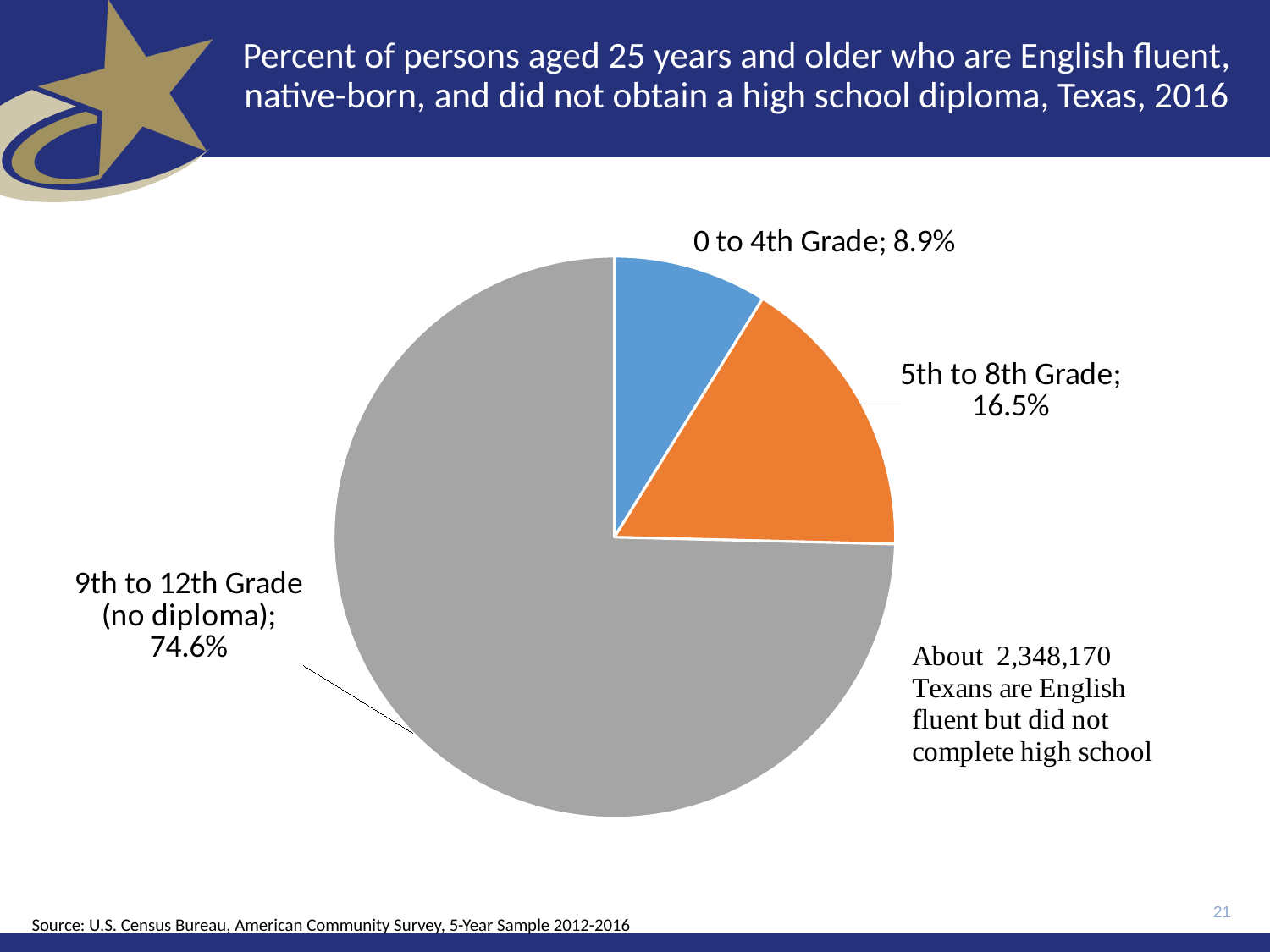
What is the difference in percentage points between the 5th to 8th Grade slice and the 0 to 4th Grade slice? 7.6 What percentage is shown for the 9th to 12th Grade (no diploma) slice? 74.6% According to the text on the slide, about how many Texans are English fluent but did not complete high school? 2,348,170 Which category has the largest share of the pie? 9th to 12th Grade (no diploma) Which category has the smallest share of the pie? 0 to 4th Grade What colour is the 5th to 8th Grade slice? orange What share of the pie does the 9th to 12th Grade (no diploma) slice represent? 74.6% Which is larger, the 5th to 8th Grade slice or the 0 to 4th Grade slice? 5th to 8th Grade What percentage is shown for the 5th to 8th Grade slice? 16.5% What type of chart is shown on the slide? pie chart How many slices does the pie chart have? 3 What percentage is shown for the 0 to 4th Grade slice? 8.9%